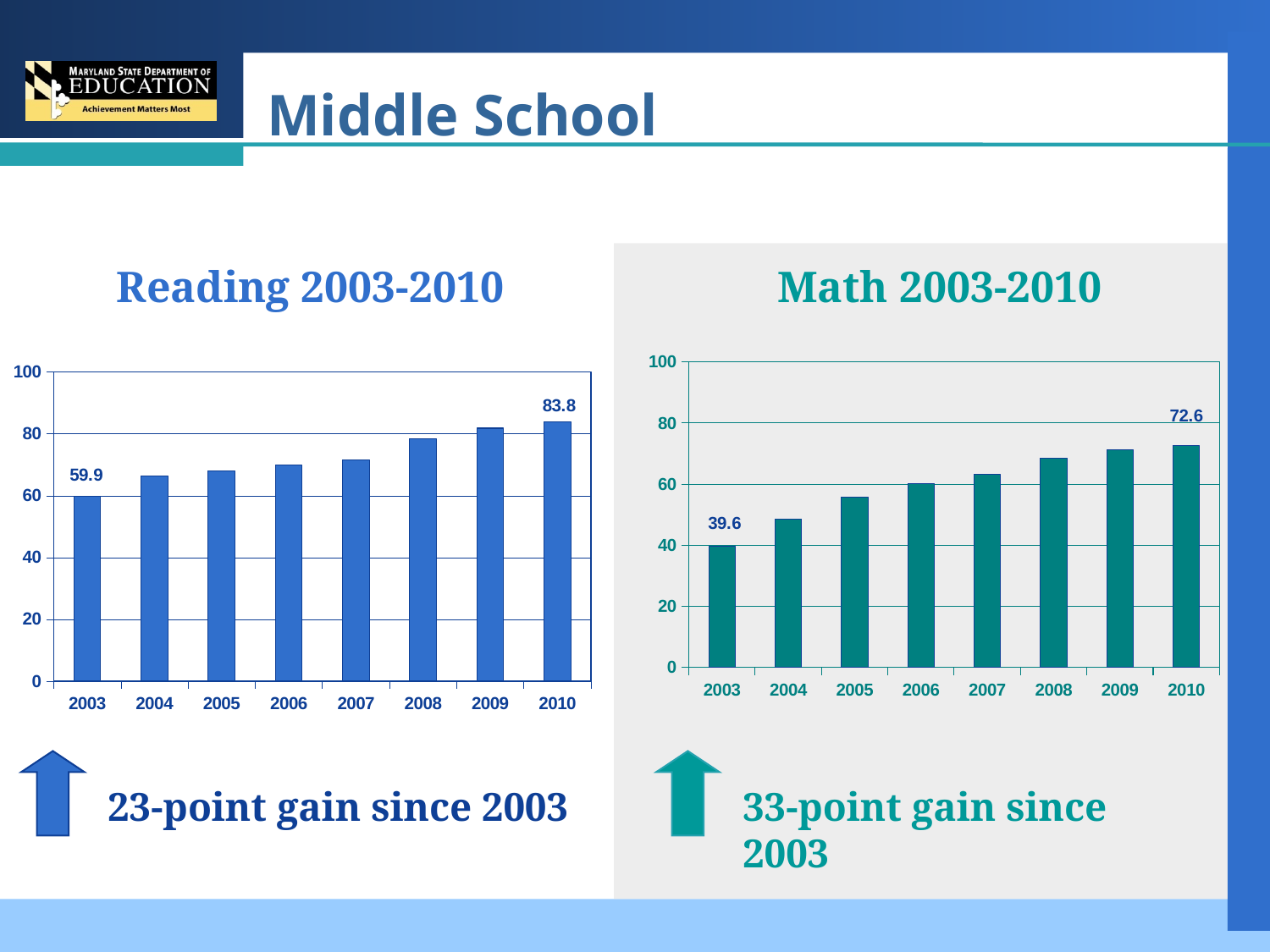
In the Math 2003-2010 chart, do the values rise or fall from 2003 to 2010? Rise In the Math 2003-2010 chart, what is the value for 2003? 39.6 In the Reading 2003-2010 chart, what is the value for 2003? 59.9 In the Math 2003-2010 chart, how many years are shown on the x axis? 8 In the Reading 2003-2010 chart, what is the value for 2010? 83.8 In the Math 2003-2010 chart, is the value for 2005 greater or less than 60? less In the Reading 2003-2010 chart, is the value for 2008 greater or less than 80? less In the Reading 2003-2010 chart, what is the difference between the 2010 value and the 2003 value? 23.9 In the Reading 2003-2010 chart, which year has the highest value? 2010 In the Math 2003-2010 chart, which year has the lowest value? 2003 In the Math 2003-2010 chart, what is the value for 2010? 72.6 What kind of chart is the Reading 2003-2010 chart? Bar chart